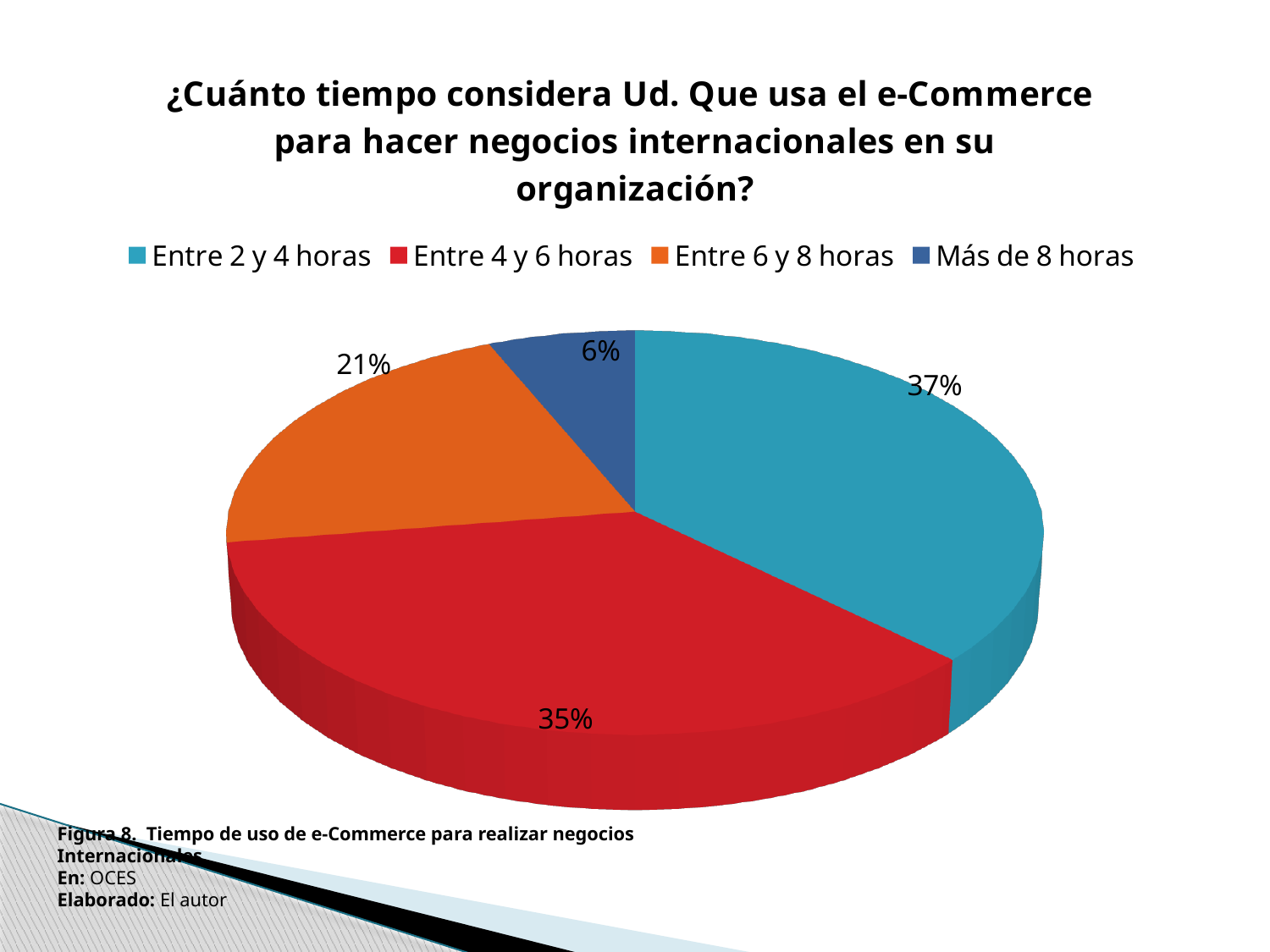
What percentage is shown for 'Entre 4 y 6 horas'? 35% What colour is the slice for 'Entre 4 y 6 horas'? Red What is the figure number given in the caption below the chart? Figura 8 Which category has the smallest share of the pie? Más de 8 horas Which is larger: the share for 'Entre 4 y 6 horas' or the share for 'Entre 6 y 8 horas'? Entre 4 y 6 horas What percentage is shown for 'Más de 8 horas'? 6% What percentage is shown for 'Entre 6 y 8 horas'? 21% How many categories does the legend list? 4 Which category has the largest share of the pie? Entre 2 y 4 horas What is the difference in percentage points between 'Entre 6 y 8 horas' and 'Más de 8 horas'? 15 What kind of chart is shown on the slide? Pie chart What percentage is shown for 'Entre 2 y 4 horas'? 37%